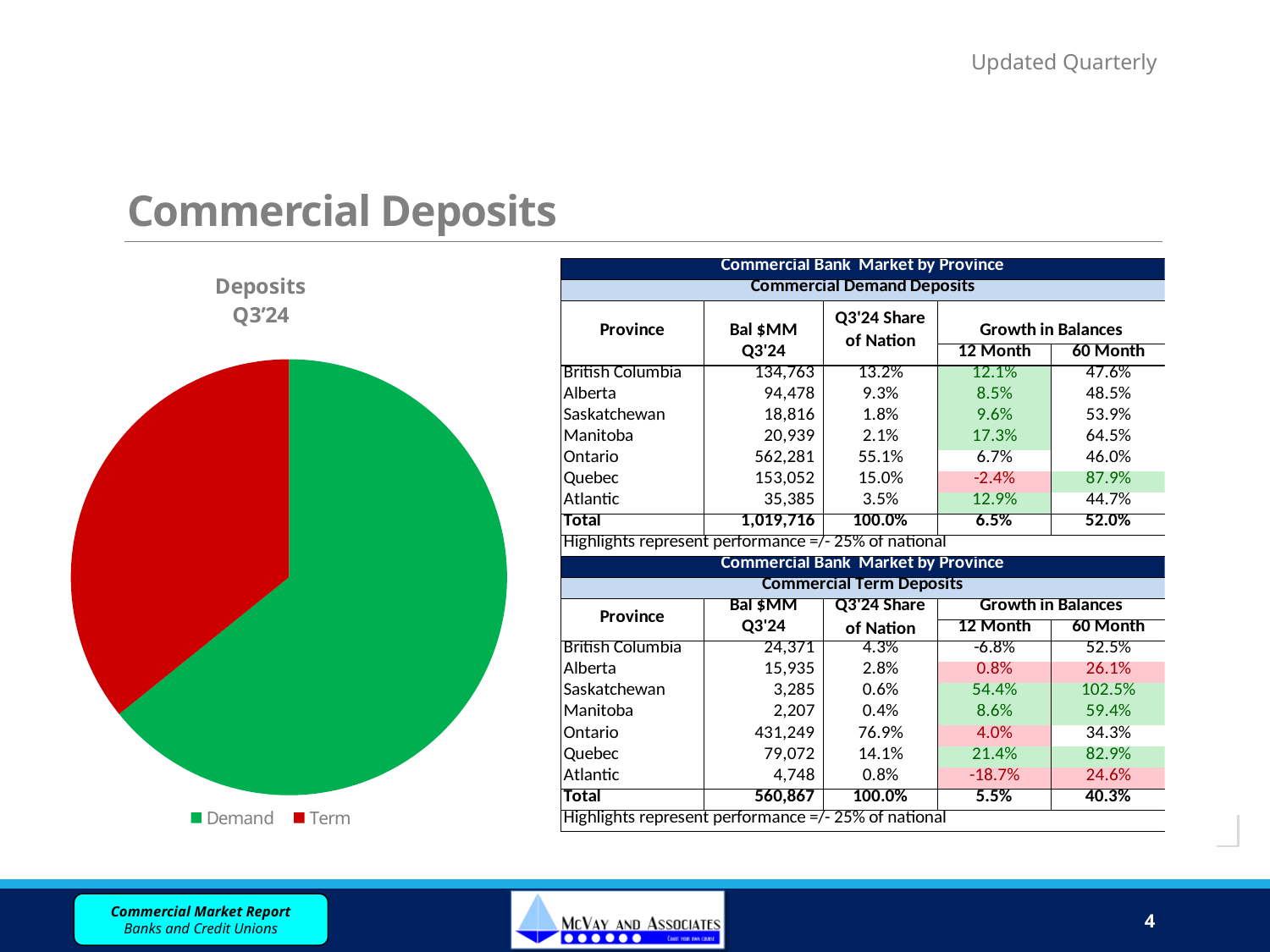
How many entries does the legend of the pie chart list? 2 What kind of chart is shown on the slide? pie chart In the pie chart, which is larger, Demand or Term? Demand What colour is the Demand slice in the pie chart? green What is the title of the pie chart? Deposits Q3'24 Which slice of the pie chart is the largest? Demand Which slice of the pie chart is the smallest? Term How many slices does the pie chart have? 2 Does the Demand slice take up more or less than half of the pie chart? more